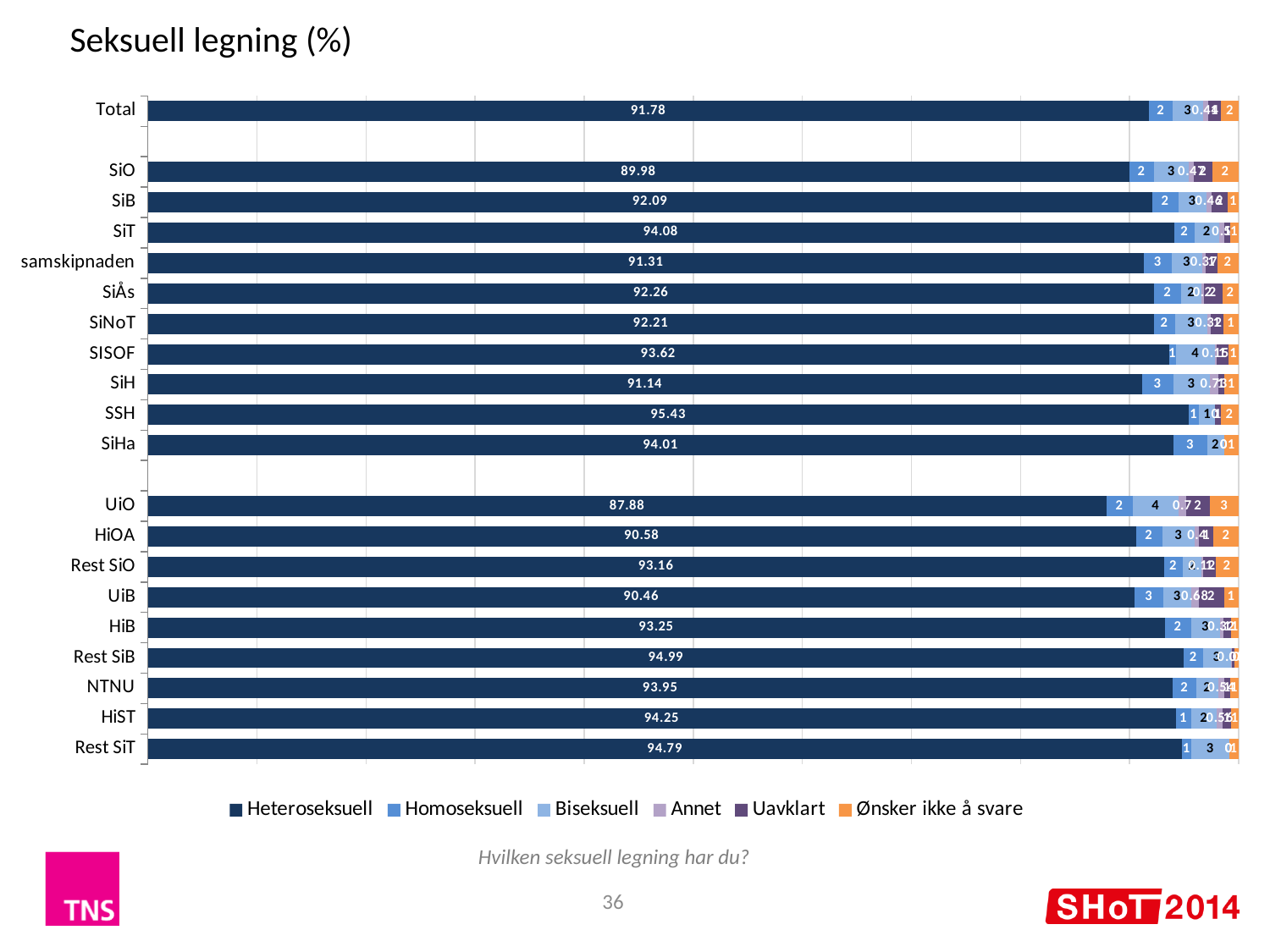
Which category has the highest Heteroseksuell value? SSH Which has a larger Heteroseksuell value, UiB or HiB? HiB What is the title of the chart? Seksuell legning (%) Which category has the lowest Heteroseksuell value? UiO How many series does the legend list? 6 How many categories are shown on the y axis? 20 What is the Heteroseksuell value for SSH? 95.43 What is the difference between the Heteroseksuell values for SSH and UiO? 7.55 What is the Heteroseksuell value for Total? 91.78 What kind of chart is shown on the slide? Stacked bar chart What is the Heteroseksuell value for HiOA? 90.58 What is the Heteroseksuell value for UiO? 87.88